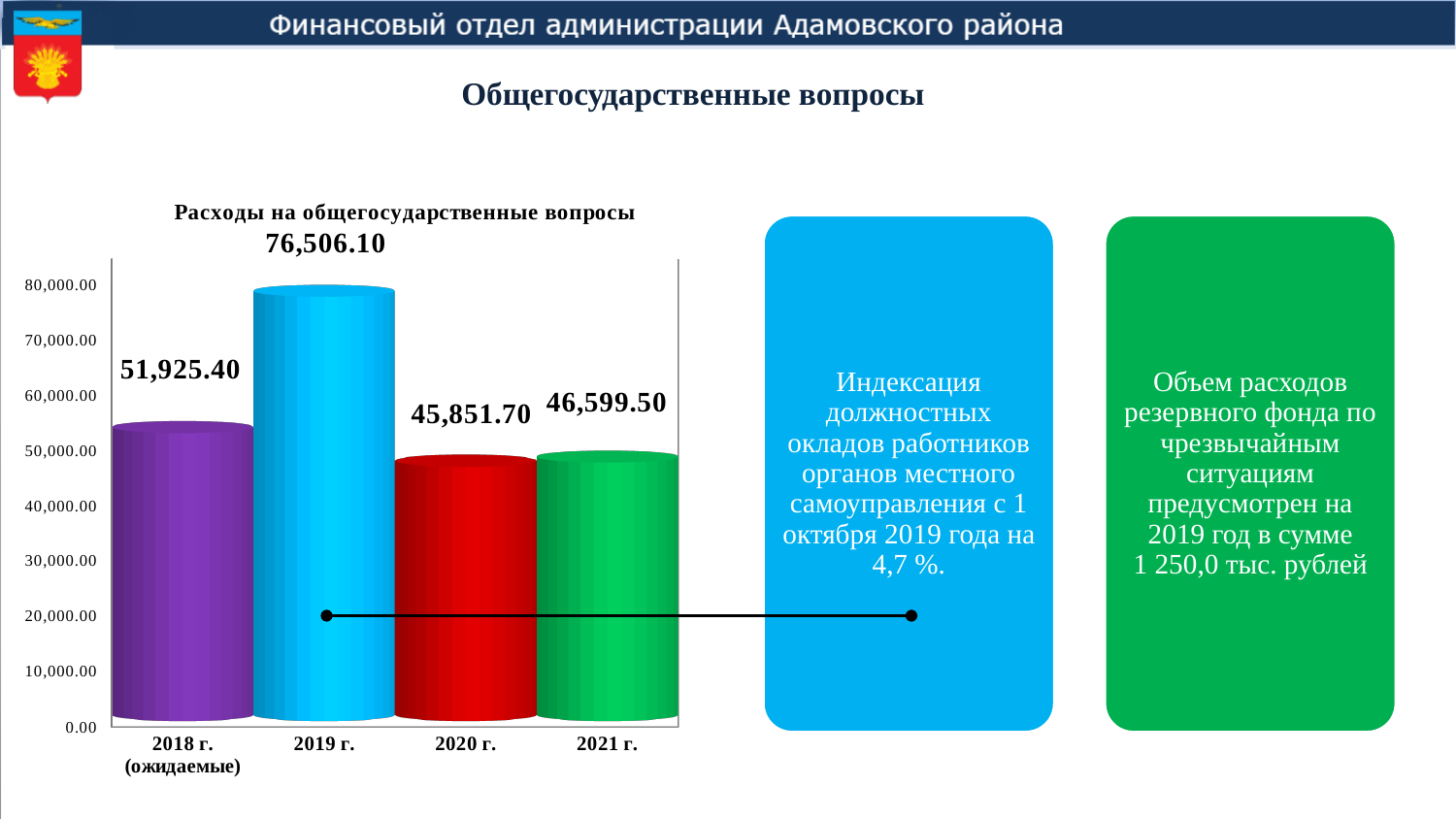
What is the value for 2021 г. in the chart? 46,599.50 Which year has the highest value in the chart? 2019 г. What is the value for 2018 г. (ожидаемые) in the chart? 51,925.40 What is the value for 2019 г. in the chart? 76,506.10 What is the title of the chart? Расходы на общегосударственные вопросы What is the difference between the values for 2021 г. and 2020 г.? 747.80 What kind of chart is shown on the slide? Bar chart Which is larger, the value for 2020 г. or the value for 2021 г.? 2021 г. What is the value for 2020 г. in the chart? 45,851.70 How many years (categories) are shown in the chart? 4 Which year has the lowest value in the chart? 2020 г. What is the difference between the values for 2019 г. and 2018 г. (ожидаемые)? 24,580.70